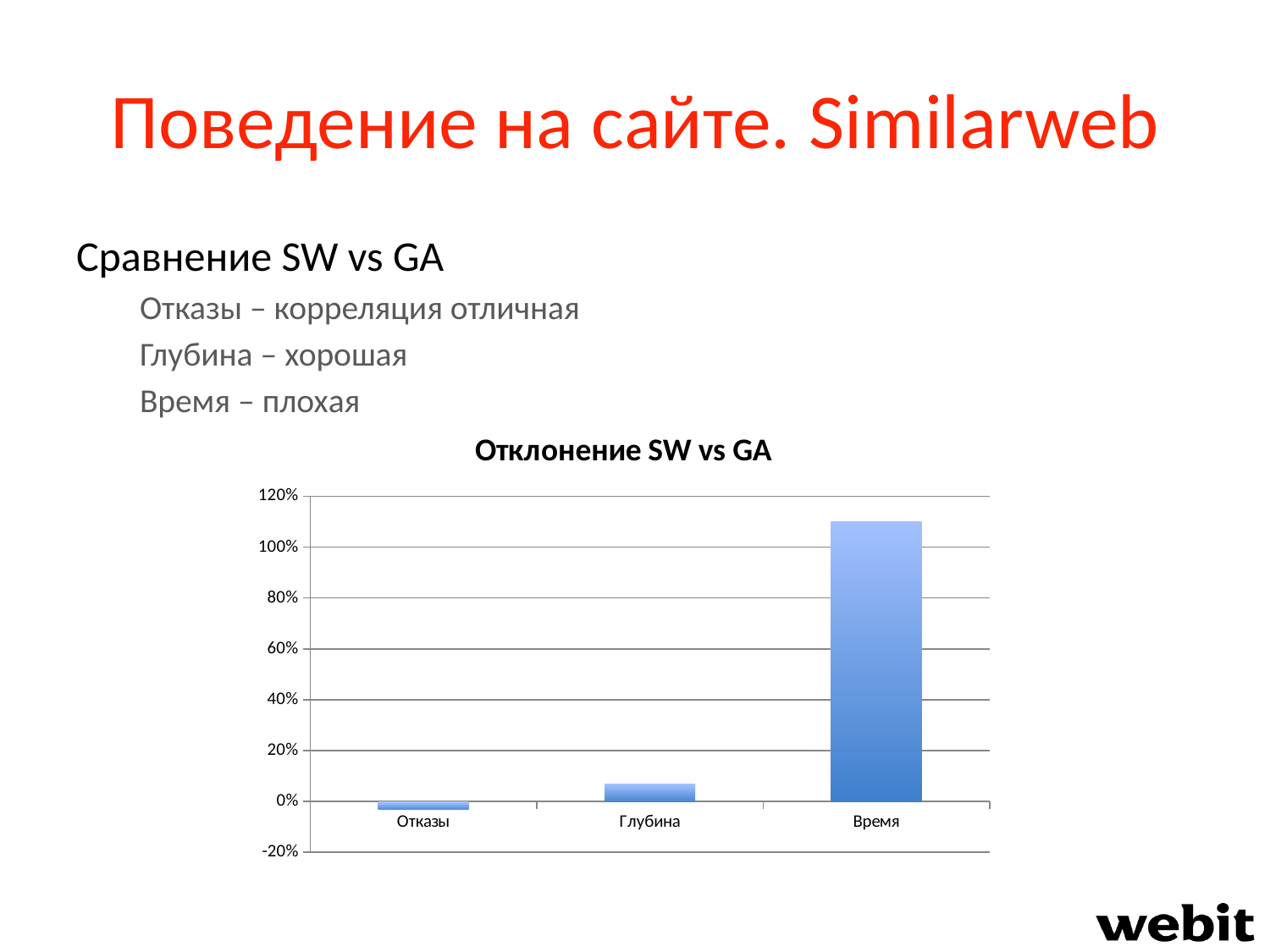
What kind of chart is shown on the slide? bar chart Which is larger, the value for Глубина or the value for Время? Время What is the lowest value shown on the vertical axis of the chart? -20% How many categories are shown on the x axis of the chart? 3 Do the values rise or fall from left to right along the x axis? rise Which category has the lowest value in the chart? Отказы Is the value for Глубина greater or less than 20%? less Which is larger, the value for Отказы or the value for Глубина? Глубина Which category has the highest value in the chart? Время Is the value for Отказы greater or less than 0%? less Is the value for Время greater or less than 100%? greater What is the title of the chart on the slide? Отклонение SW vs GA